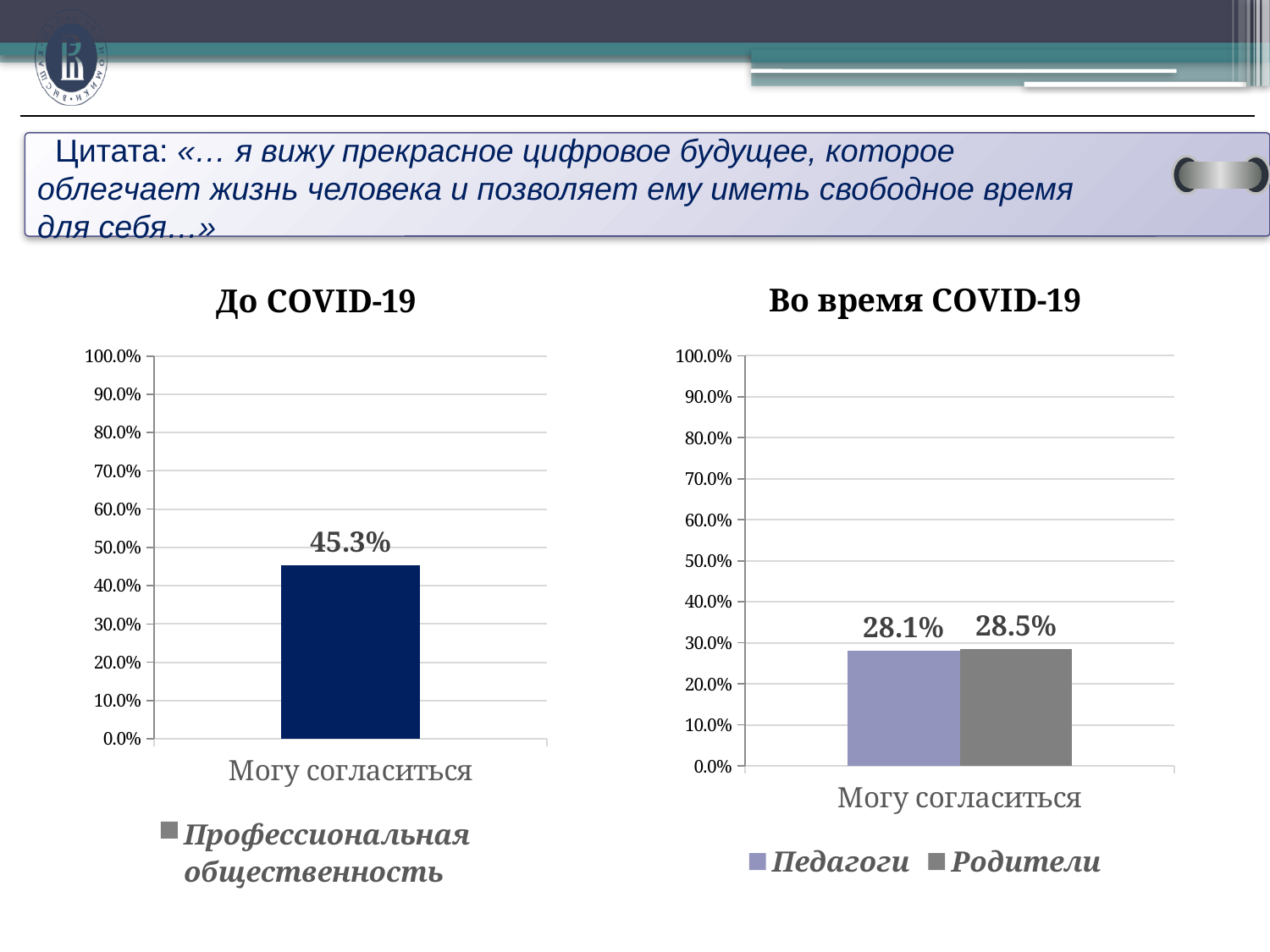
What is the difference between the 'Профессиональная общественность' value in the 'До COVID-19' chart and the 'Родители' value in the 'Во время COVID-19' chart? 16.8% In the 'Во время COVID-19' chart, how many series does the legend list? 2 In the 'Во время COVID-19' chart, what is the difference between the values for 'Родители' and 'Педагоги'? 0.4% In the 'До COVID-19' chart, is the value for 'Могу согласиться' greater or less than 50%? less How many categories are shown on the x axis of the 'Во время COVID-19' chart? 1 What kind of chart is the 'До COVID-19' chart? Bar chart In the 'Во время COVID-19' chart, what is the value for 'Родители'? 28.5% In the 'Во время COVID-19' chart, what is the value for 'Педагоги'? 28.1% In the 'Во время COVID-19' chart, is the value for 'Педагоги' greater or less than 20%? greater In the 'До COVID-19' chart, how many series does the legend list? 1 In the 'До COVID-19' chart, what is the value for 'Профессиональная общественность' for 'Могу согласиться'? 45.3% What is the title of the chart on the right side of the slide? Во время COVID-19